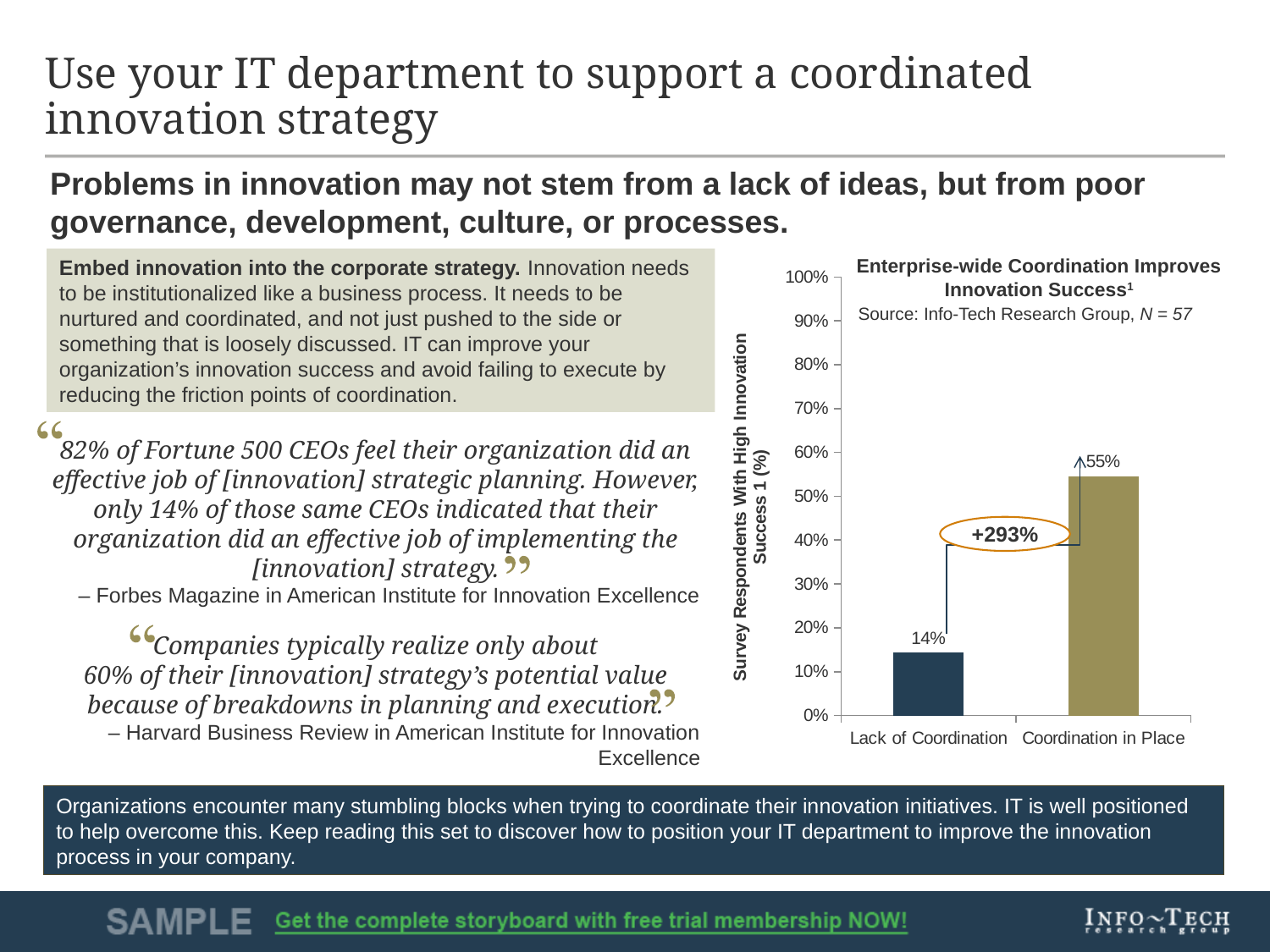
Which category has the lowest value? Lack of Coordination Which is larger, the value for Lack of Coordination or the value for Coordination in Place? Coordination in Place What kind of chart is shown? Bar chart How many categories are shown on the x axis? 2 What is the value for Lack of Coordination? 14% What is the difference between the values for Coordination in Place and Lack of Coordination? 41% What is the title of the chart? Enterprise-wide Coordination Improves Innovation Success Is the value for Lack of Coordination greater or less than 20%? less What percentage increase is annotated between the two bars? +293% Which category has the highest value? Coordination in Place Is the value for Coordination in Place greater or less than 50%? greater What is the value for Coordination in Place? 55%